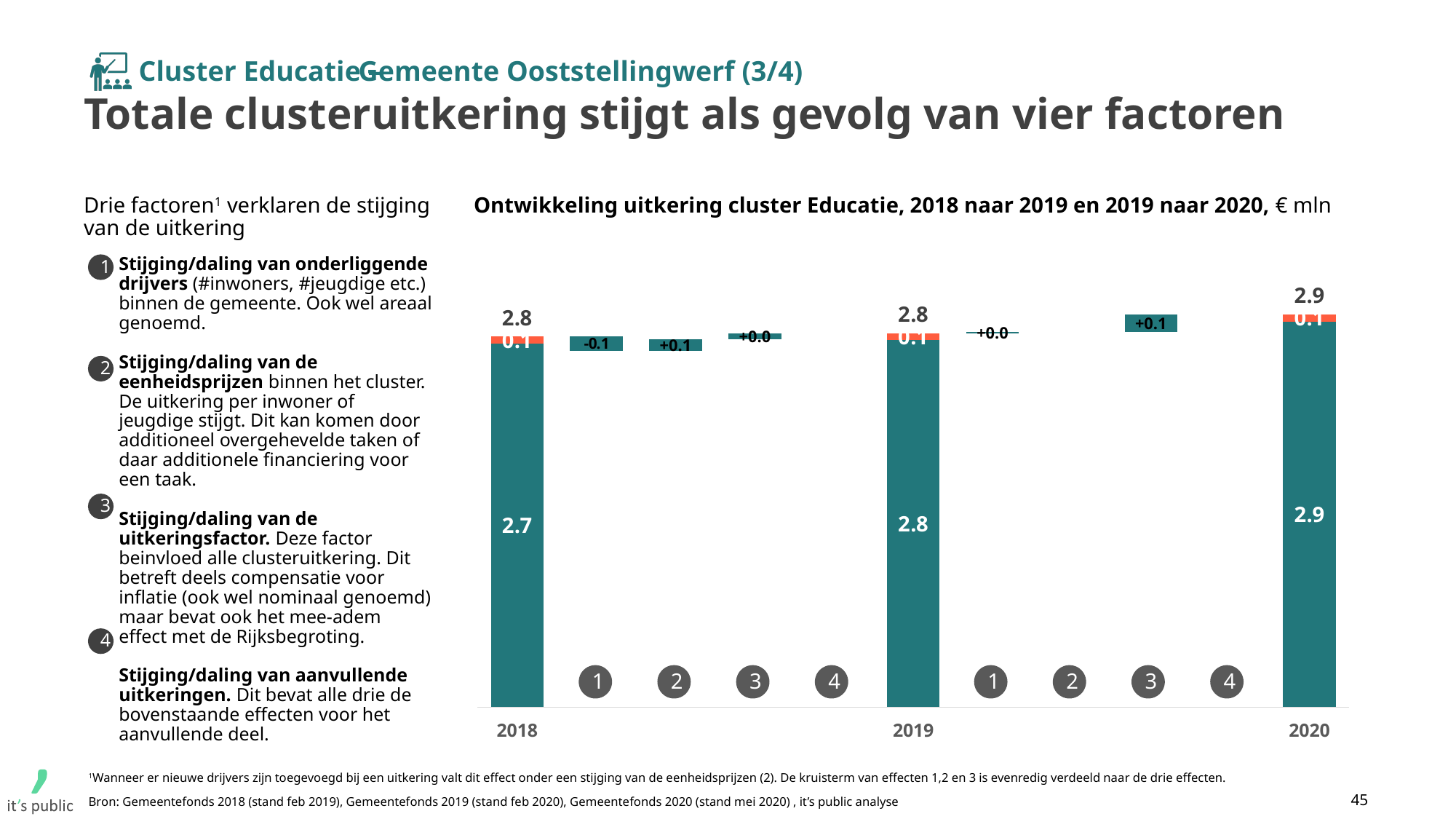
What is the effect of factor 2 in the step from 2018 to 2019? +0.1 What is the effect of factor 1 in the step from 2019 to 2020? +0.0 What value is printed inside the large teal segment of the 2019 bar? 2.8 In what unit are the values in the chart expressed, according to the chart title? € mln What is the total uitkering for cluster Educatie in 2020 shown on the chart? 2.9 By how much does the total uitkering in 2020 exceed the total in 2018? 0.1 What is the effect of factor 3 in the step from 2019 to 2020? +0.1 What is the total uitkering for cluster Educatie in 2018 shown on the chart? 2.8 What value is printed inside the large teal segment of the 2018 bar? 2.7 What kind of chart is used to show the development of the uitkering? Bar chart (waterfall) What is the effect of factor 1 in the step from 2018 to 2019? -0.1 Which year has the higher total uitkering, 2018 or 2020? 2020